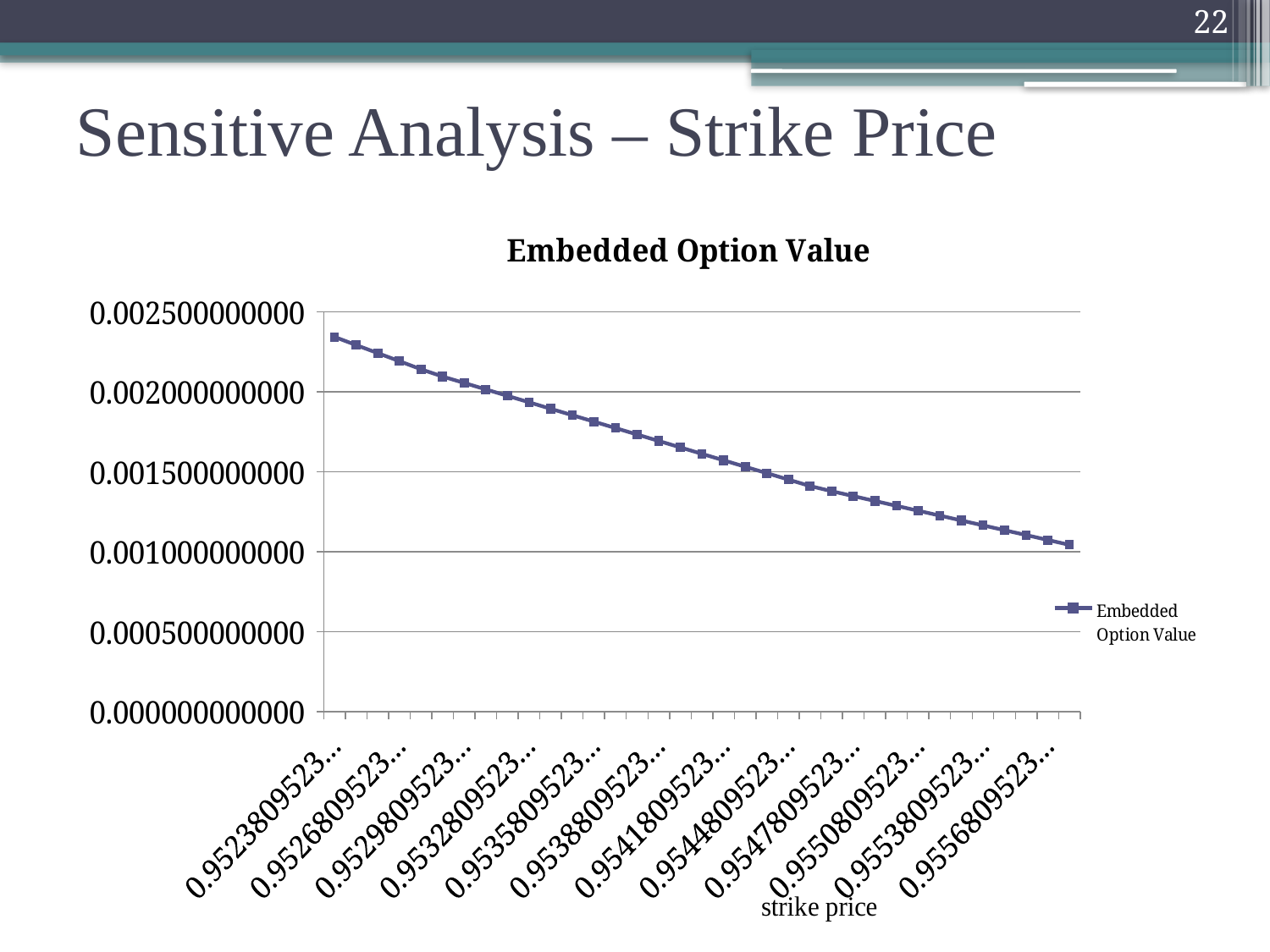
Is the value at the rightmost point of the line greater or less than 0.001500000000? less How many series does the legend list? 1 Is the value at the leftmost point (strike price 0.9523809523...) greater or less than 0.002000000000? greater Is the value at the point labelled 0.9541809523... greater or less than 0.002000000000? less What is the title of the chart? Embedded Option Value What is the label of the x axis? strike price Do the values rise or fall as the strike price increases along the x axis? fall What kind of chart is shown on the slide? line chart Which has the larger embedded option value: the leftmost point or the rightmost point? the leftmost point